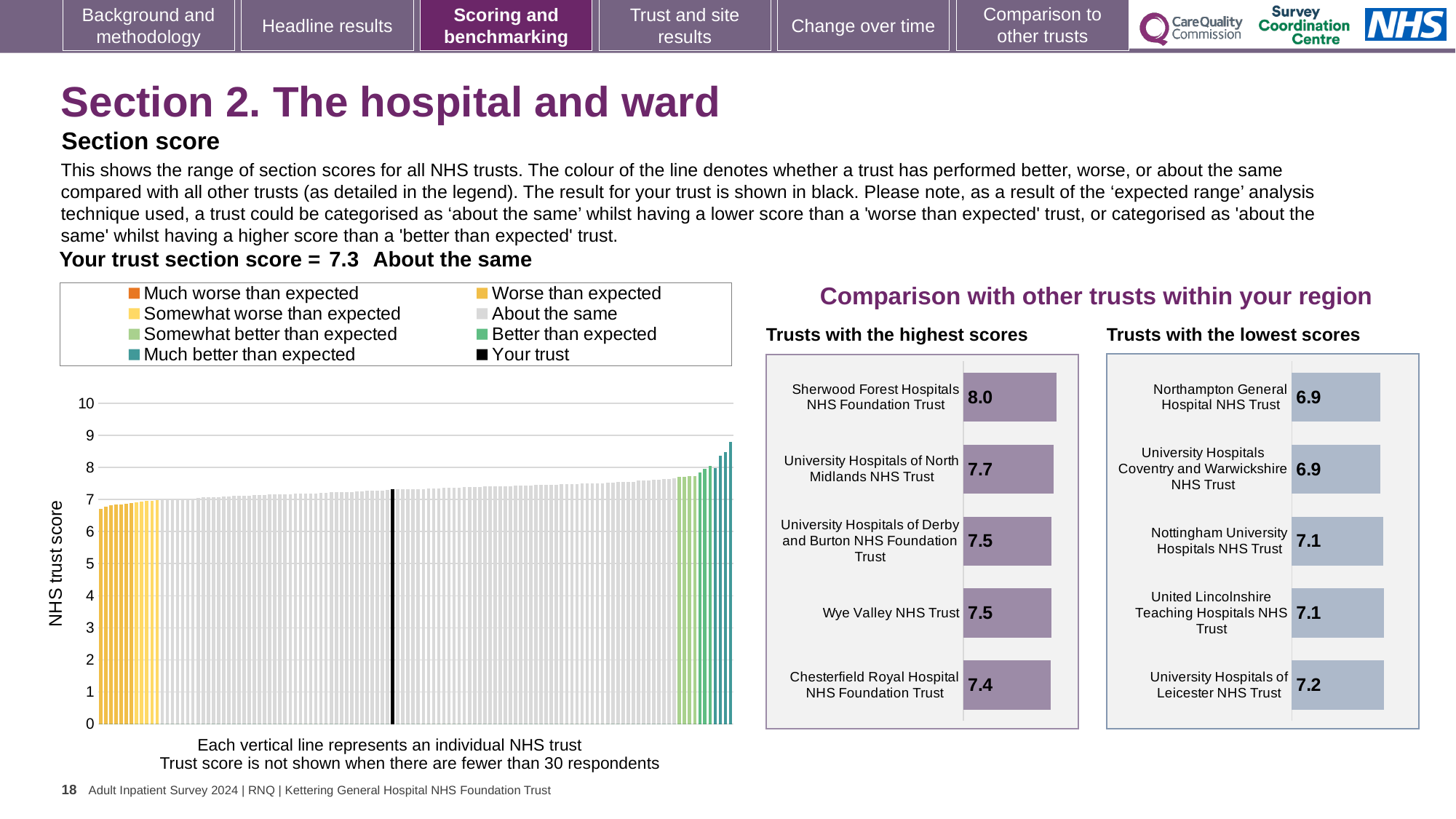
What is the section score for your trust shown above the main chart of all NHS trusts? 7.3 In the 'Trusts with the lowest scores' chart, which trust has the highest score? University Hospitals of Leicester NHS Trust In the 'Trusts with the highest scores' chart, what is the score for Chesterfield Royal Hospital NHS Foundation Trust? 7.4 In the 'Trusts with the highest scores' chart, which has the larger score: University Hospitals of North Midlands NHS Trust or Wye Valley NHS Trust? University Hospitals of North Midlands NHS Trust In the 'Trusts with the highest scores' chart, what is the score for Sherwood Forest Hospitals NHS Foundation Trust? 8.0 How many trusts are shown in the 'Trusts with the highest scores' chart? 5 In the 'Trusts with the highest scores' chart, what is the difference between the scores of Sherwood Forest Hospitals NHS Foundation Trust and Chesterfield Royal Hospital NHS Foundation Trust? 0.6 In the 'Trusts with the lowest scores' chart, what is the score for Nottingham University Hospitals NHS Trust? 7.1 In the 'Trusts with the lowest scores' chart, what is the difference between the scores of University Hospitals of Leicester NHS Trust and Northampton General Hospital NHS Trust? 0.3 How many entries does the legend of the main chart of all NHS trusts list? 8 In the main chart of all NHS trusts, do the trust scores rise or fall from left to right along the x axis? rise In the 'Trusts with the highest scores' chart, which trust has the highest score? Sherwood Forest Hospitals NHS Foundation Trust